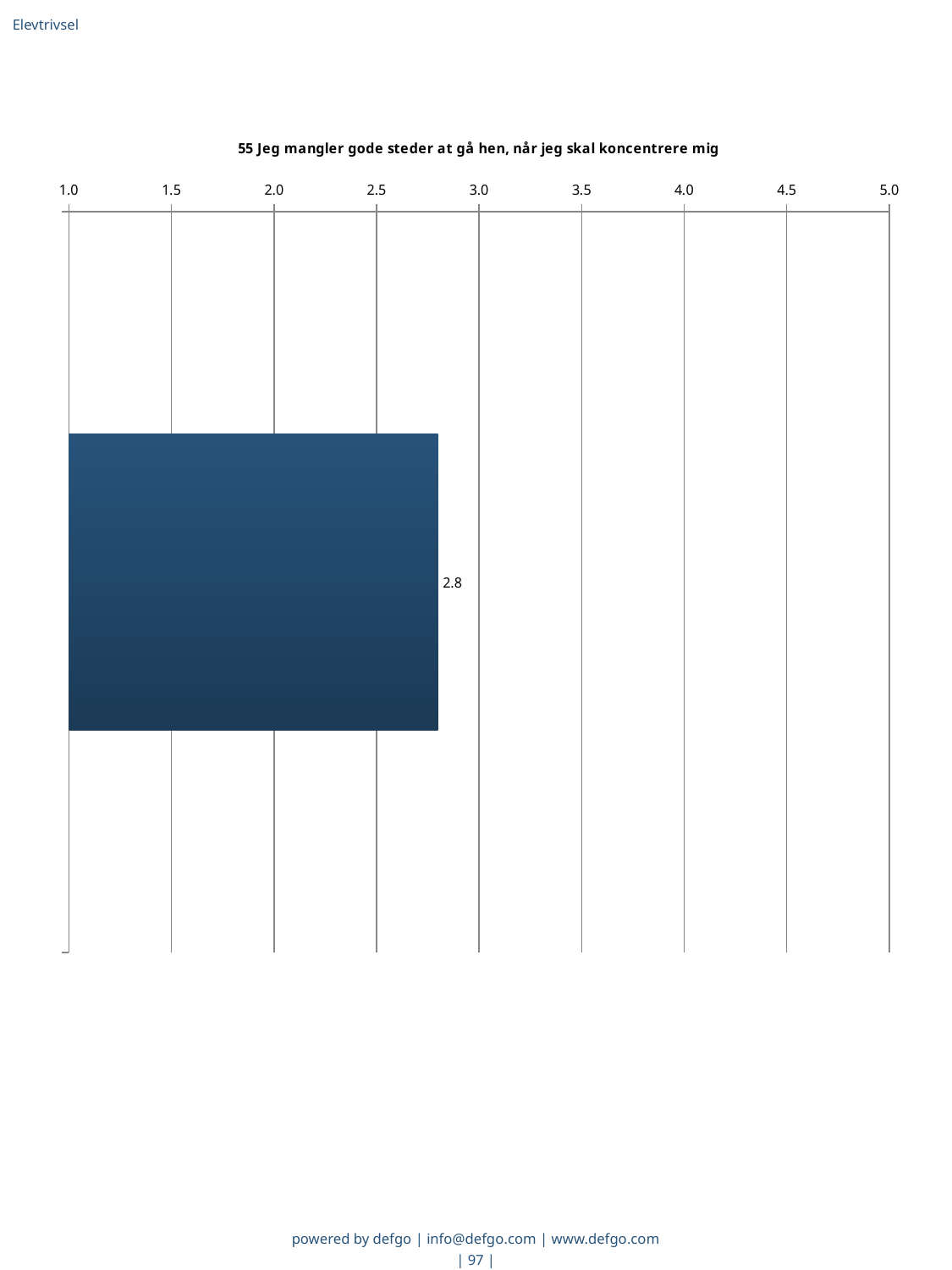
What is the highest value shown on the chart's axis? 5.0 Are the bars in the chart horizontal or vertical? horizontal How many bars are plotted in the chart? 1 What kind of chart is shown on the slide? bar chart Is the value of the bar greater or less than 4.0? less What is the title of the chart? 55 Jeg mangler gode steder at gå hen, når jeg skal koncentrere mig Is the value of the bar greater or less than 3.0? less Is the value of the bar greater or less than 2.5? greater What value is shown by the bar in the chart? 2.8